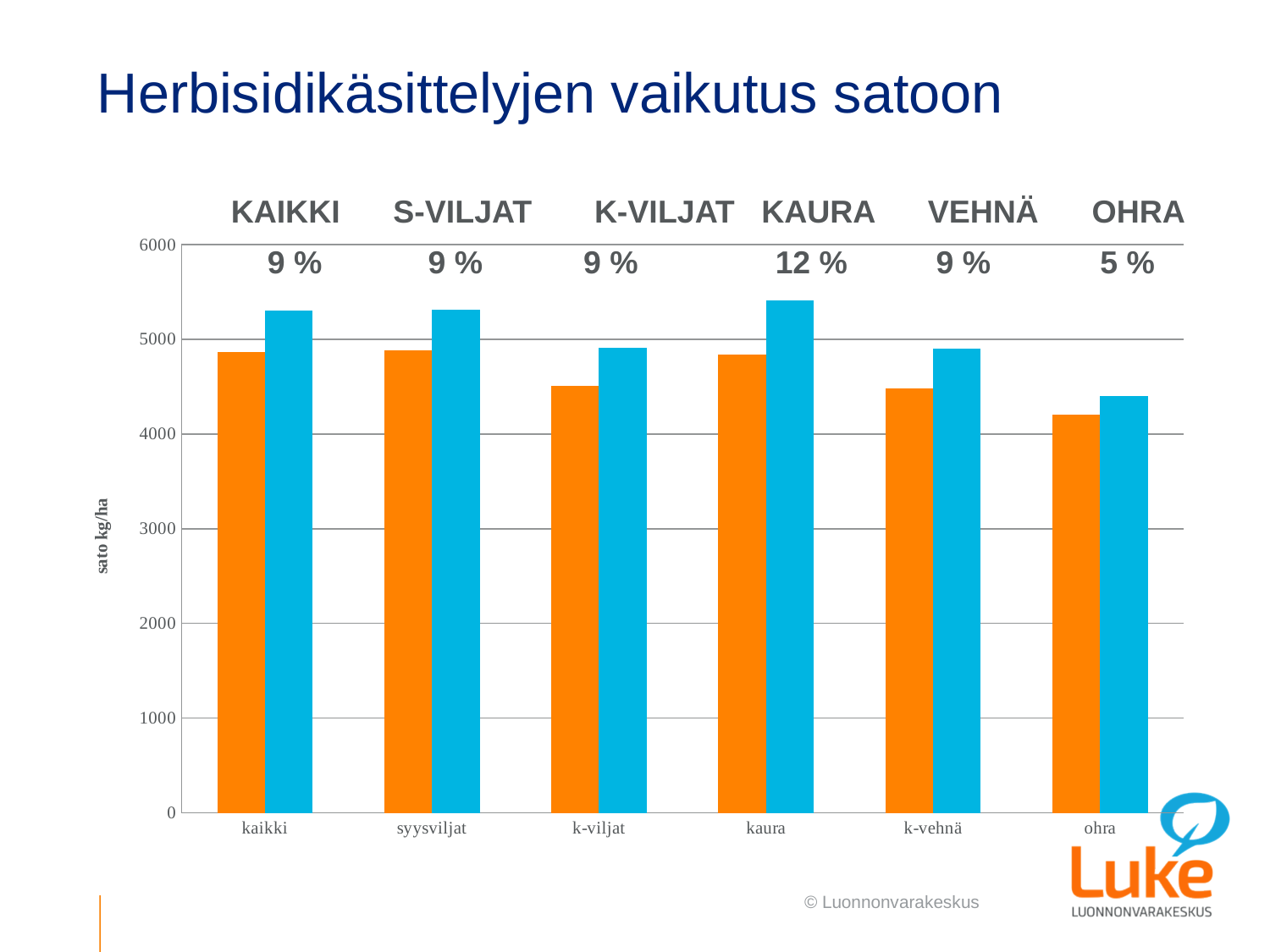
What percentage is printed above the ohra category? 5 % What is the label on the y axis of the chart? sato kg/ha What percentage is printed above the kaura category? 12 % How many categories are shown on the x axis of the chart? 6 Which category has the highest percentage printed above it? kaura Which category has the lowest orange bar? ohra What kind of chart is shown on the slide? bar chart Is the orange bar for ohra greater or less than 5000? less Which category has the tallest blue bar? kaura Which category has the lowest percentage printed above it? ohra Is the blue bar for kaura greater or less than 5000? greater Is the orange bar for k-viljat greater or less than 4000? greater